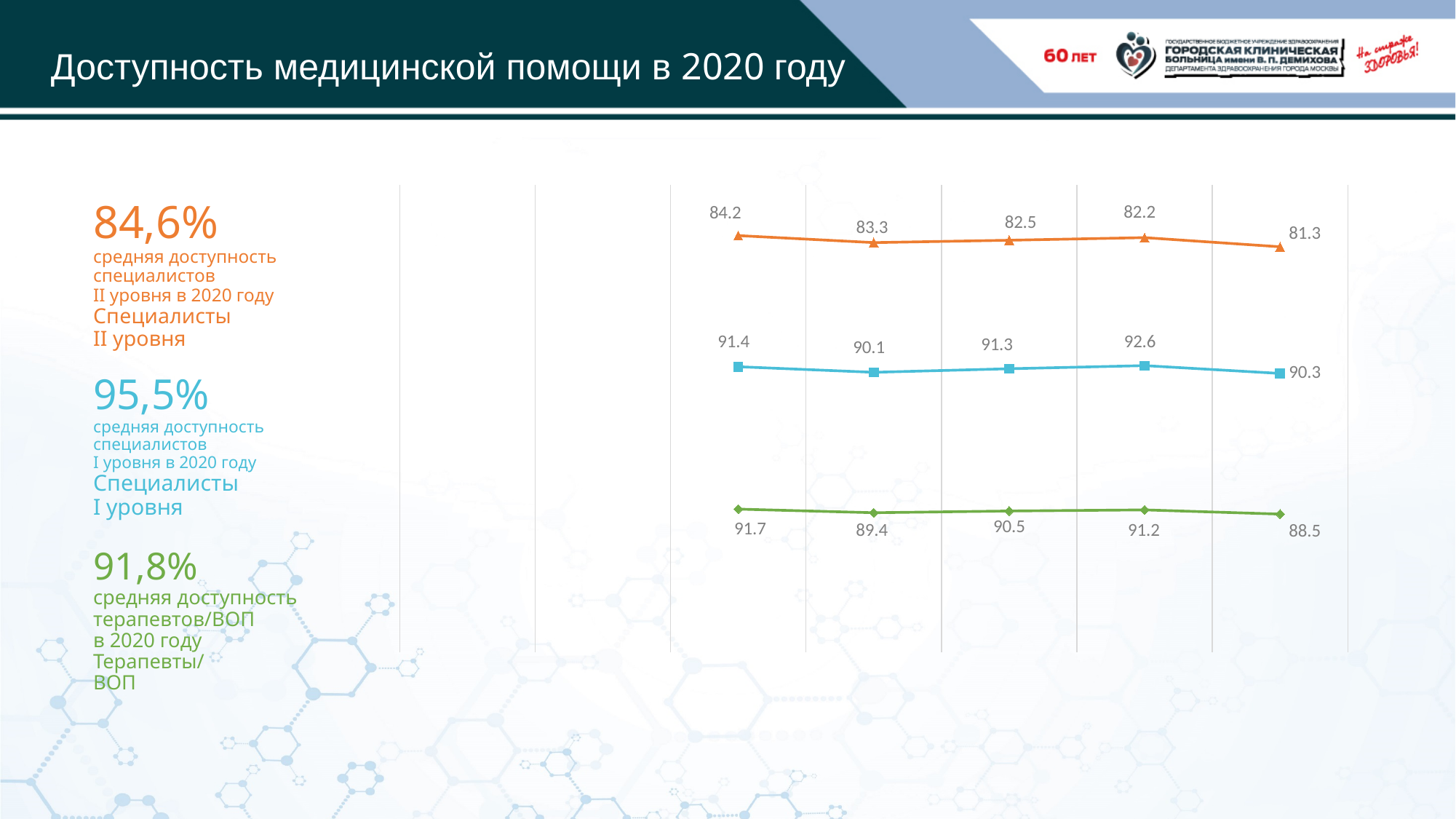
How many lines (series) are plotted in the chart? 3 What is the first (leftmost) value of the orange line (Специалисты II уровня)? 84.2 What is the highest value on the blue line (Специалисты I уровня)? 92.6 What is the lowest value on the green line (Терапевты/ВОП)? 88.5 At the fourth point, which is higher: the blue line (Специалисты I уровня) or the green line (Терапевты/ВОП)? blue line (Специалисты I уровня) What kind of chart is shown on the slide? line chart What is the difference between the first and last values of the orange line (Специалисты II уровня)? 2.9 Does the orange line (Специалисты II уровня) rise or fall from left to right? fall Which colour is used for the Терапевты/ВОП line? green What is the second value of the green line (Терапевты/ВОП)? 89.4 How many data points does each line in the chart have? 5 What is the last (rightmost) value of the blue line (Специалисты I уровня)? 90.3